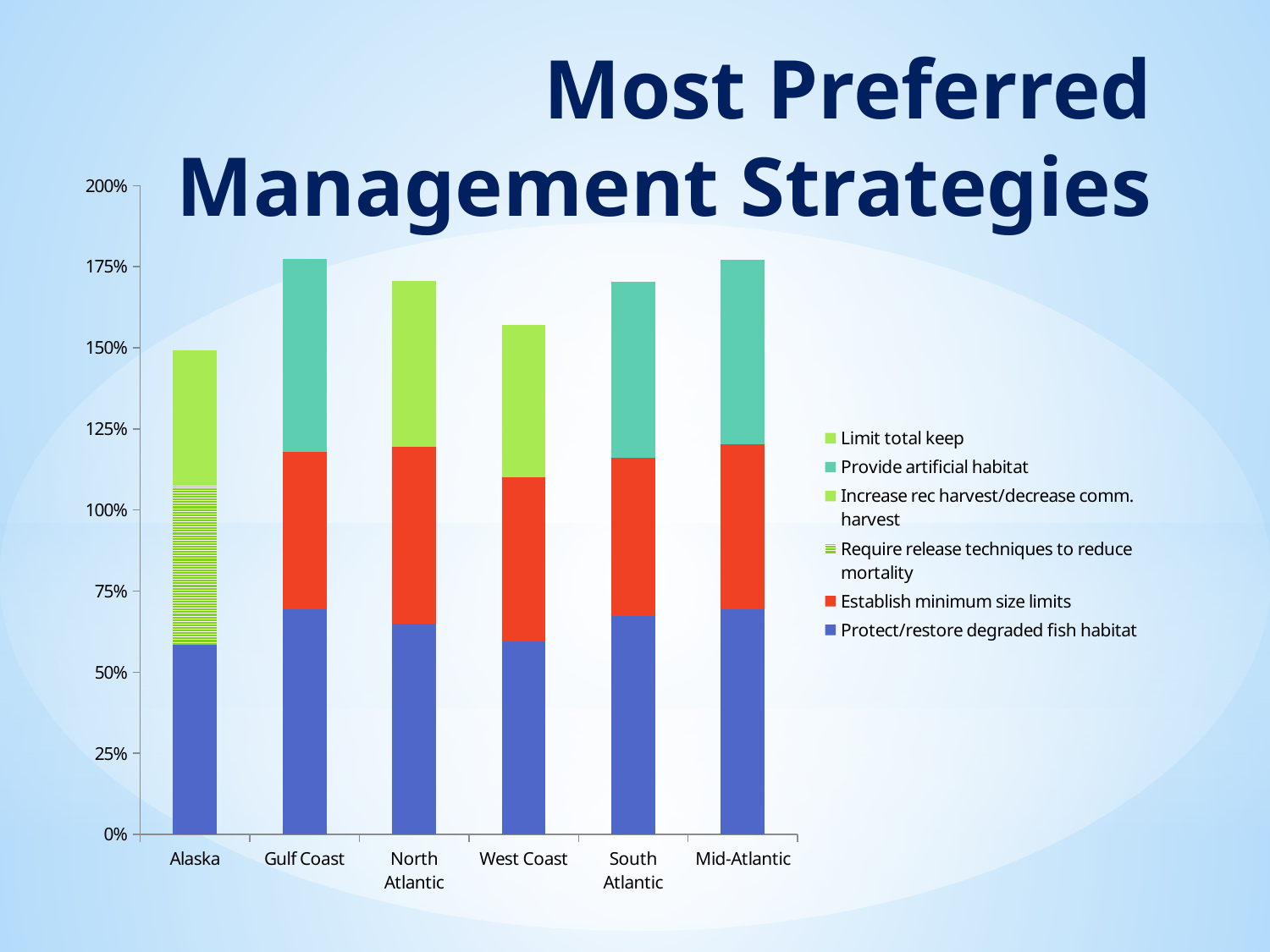
Which region has the lowest total stacked bar? Alaska Is the total stacked bar for West Coast greater or less than 150%? greater Which has the larger total stacked bar, Alaska or West Coast? West Coast What kind of chart is shown on the slide? Stacked bar chart Which region is the only one with a 'Require release techniques to reduce mortality' segment? Alaska What is the title of the chart? Most Preferred Management Strategies Is the total stacked bar for Alaska greater or less than 125%? greater Is the Protect/restore degraded fish habitat value for Alaska greater or less than 50%? greater How many series does the legend list? 6 Which has the larger total stacked bar, Gulf Coast or West Coast? Gulf Coast How many regions are shown along the x axis? 6